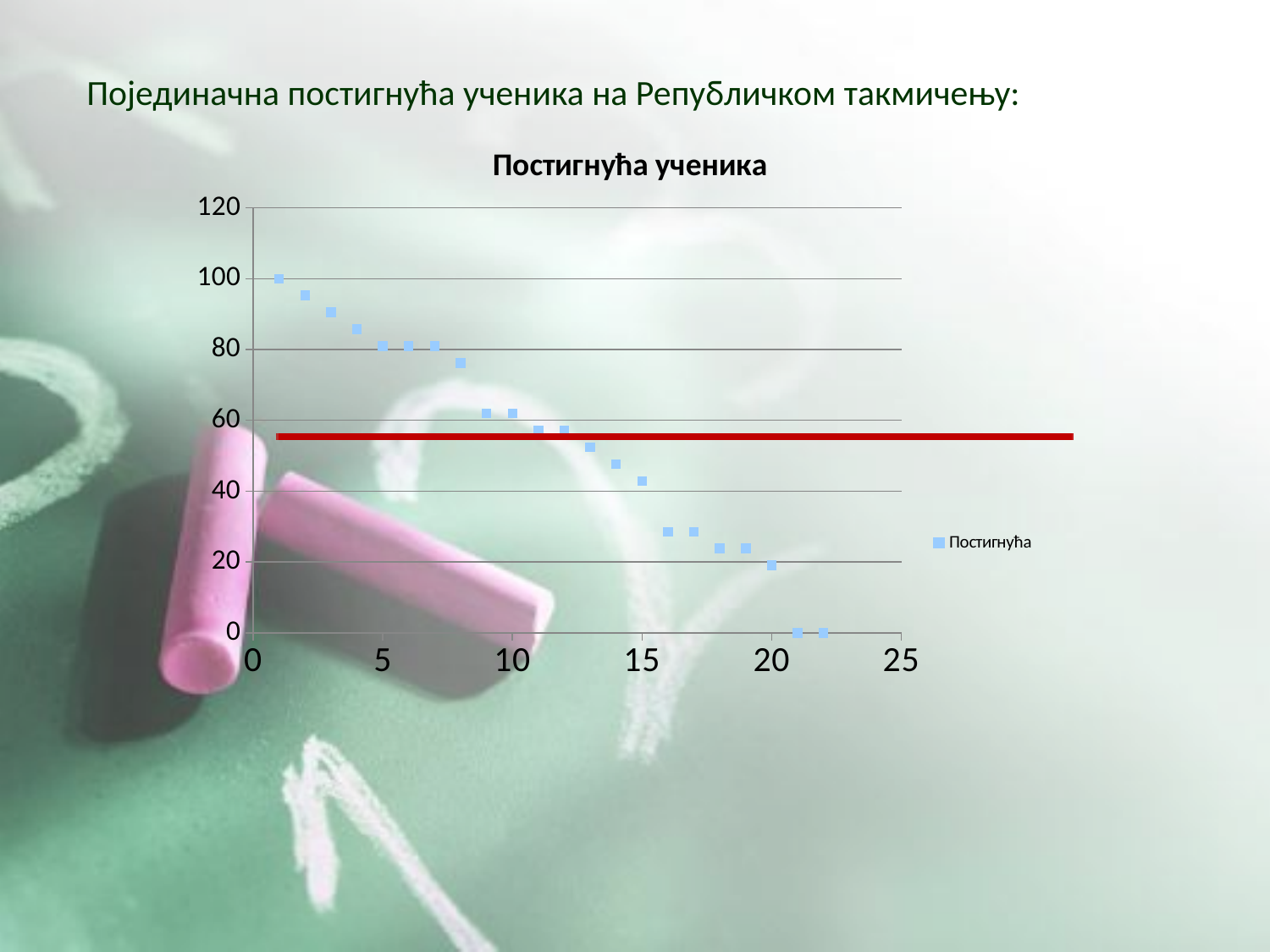
Do the plotted values rise or fall as the x value increases? fall What is the value of the point at x = 1? 100 How many data points are plotted in the chart? 22 Which x value has the highest plotted value? 1 How many series does the legend list? 1 What is the title of the chart? Постигнућа ученика Is the value for x = 15 greater or less than 60? less Is the value for x = 2 greater or less than 80? greater What is the value of the point at x = 21? 0 What kind of chart is shown on the slide? scatter chart What is the name of the series shown in the legend? Постигнућа Is the value for x = 8 greater or less than 60? greater